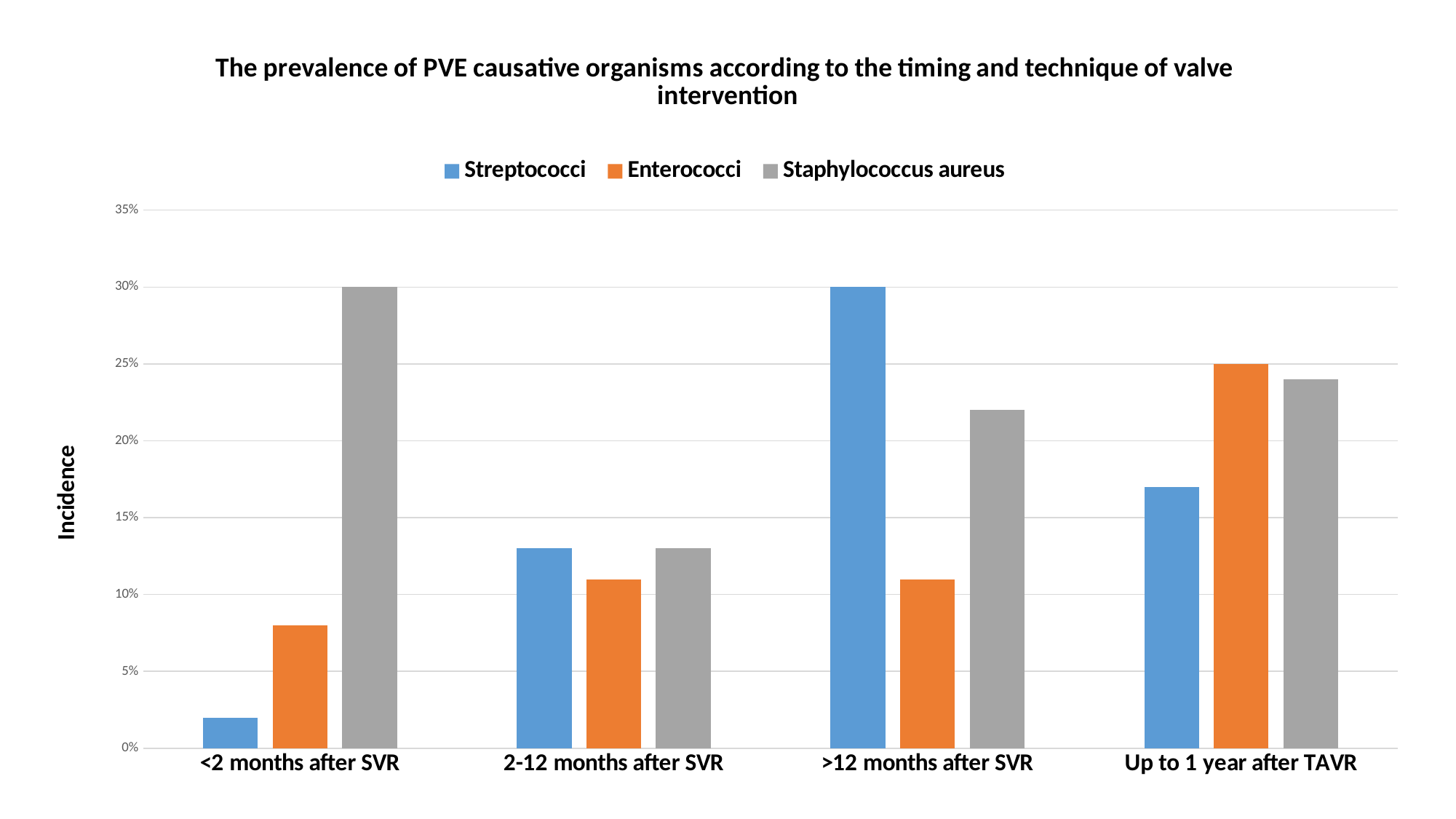
Is the value for Staphylococcus aureus for >12 months after SVR greater or less than 20%? greater What is the incidence of Enterococci for Up to 1 year after TAVR? 25% How many series does the legend list? 3 How many categories are shown on the x axis? 4 What is the incidence of Streptococci for >12 months after SVR? 30% What is the incidence of Staphylococcus aureus for <2 months after SVR? 30% Is the value for Streptococci for <2 months after SVR greater or less than 5%? less What kind of chart is shown on the slide? bar chart What is the label of the y axis? Incidence For Up to 1 year after TAVR, which is larger: Streptococci or Enterococci? Enterococci Which organism has the lowest incidence for <2 months after SVR? Streptococci Which organism has the highest incidence for <2 months after SVR? Staphylococcus aureus